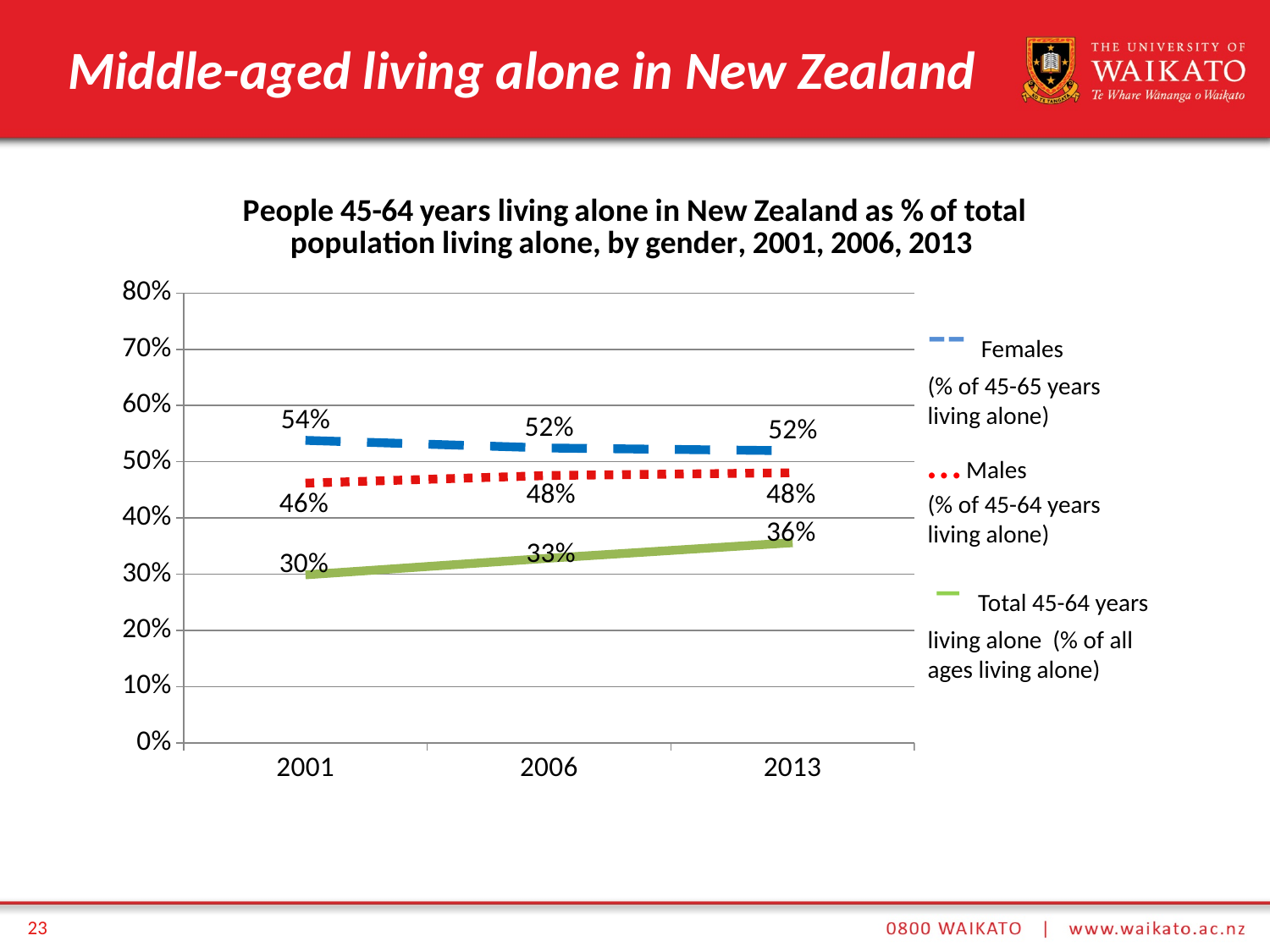
What is the difference between the Females and Males values in 2001? 8% How many years are shown on the x axis? 3 What is the value for Males in 2013? 48% What colour is the Males line? Red In which year is the Total 45-64 years living alone series lowest? 2001 What kind of chart is this? Line chart What is the value for Females in 2001? 54% What is the value for Total 45-64 years living alone in 2006? 33% How many series does the legend list? 3 Which is larger in 2013, the Females value or the Males value? Females In which year is the Females series highest? 2001 Does the Total 45-64 years living alone series rise or fall from 2001 to 2013? Rise